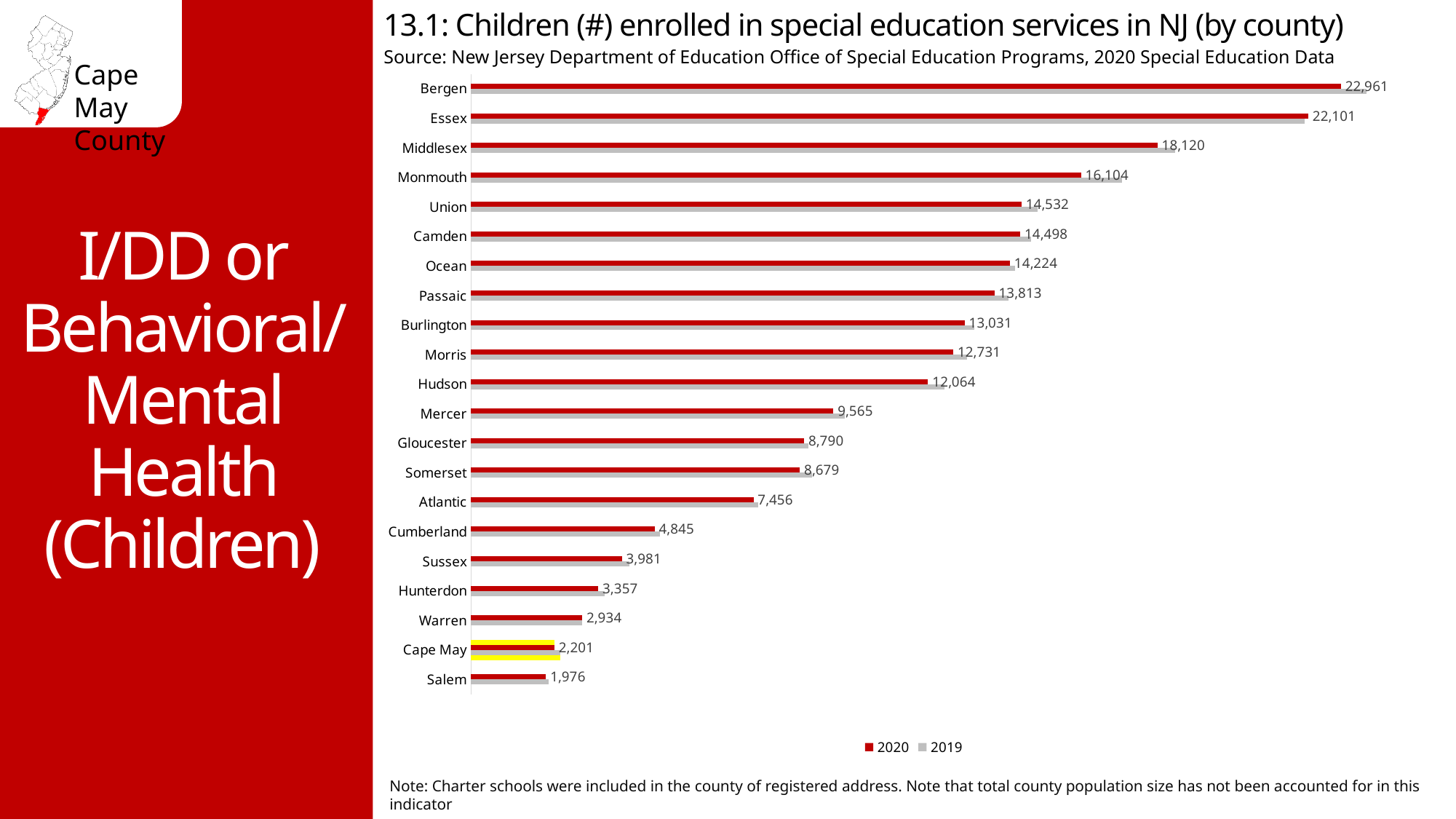
What is the 2020 value for Cape May? 2,201 Which county has the lowest 2020 value? Salem What kind of chart is shown on the slide? Bar chart What is the 2020 value for Atlantic? 7,456 What is the 2020 value for Bergen? 22,961 What is the difference between the 2020 values for Cape May and Salem? 225 How many series does the legend list? 2 Which has the larger 2020 value, Mercer or Gloucester? Mercer Which county's bars are highlighted in yellow? Cape May Which county has the highest 2020 value? Bergen What is the difference between the 2020 values for Bergen and Essex? 860 How many counties are shown in the chart? 21